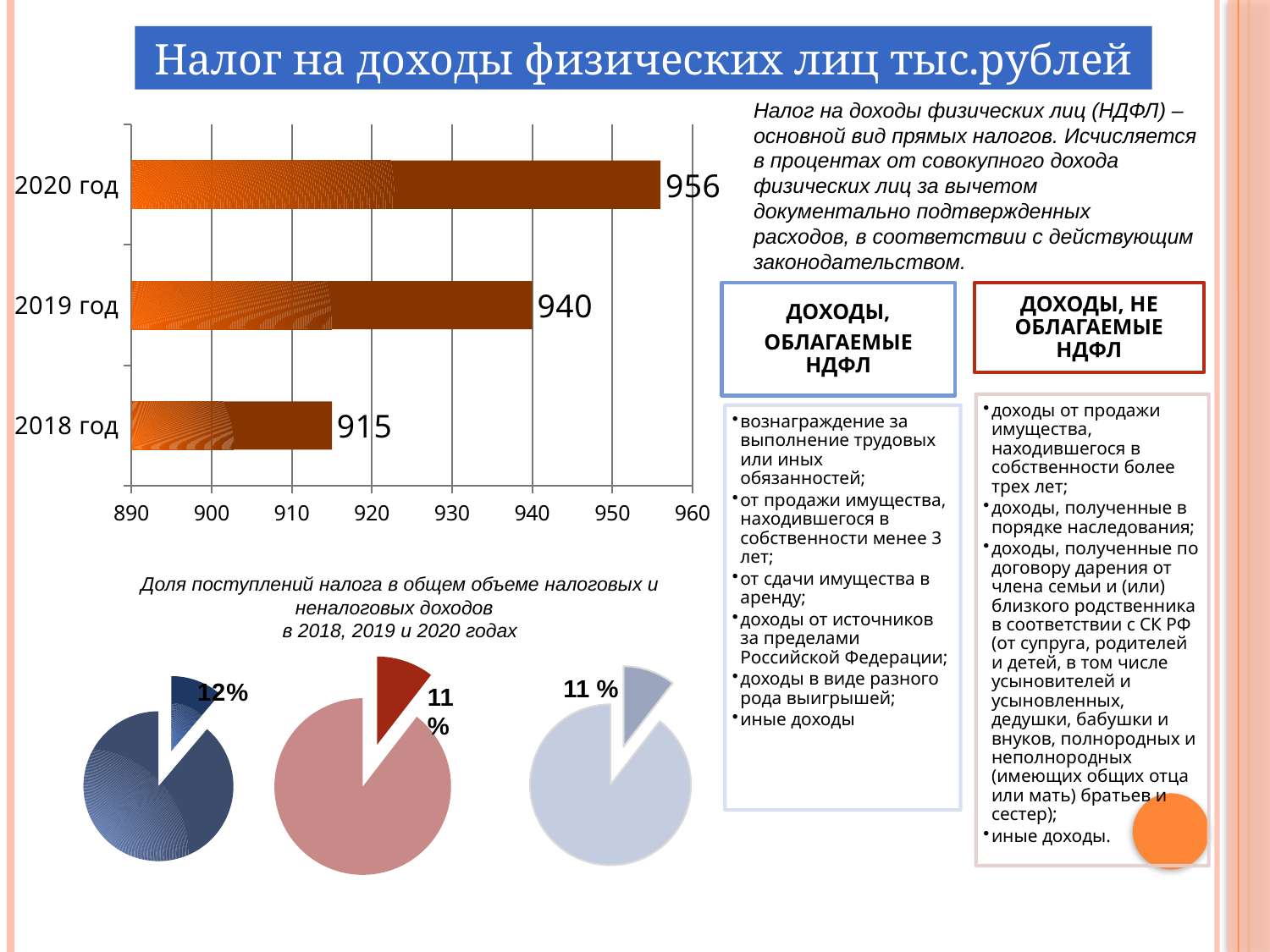
In the bar chart, what is the difference between the values for 2020 год and 2018 год? 41 In the bar chart, what is the value for 2018 год? 915 In the bar chart, do the values rise or fall from 2018 to 2020? rise In the bar chart, which year has the highest value? 2020 год In the bar chart, what is the value for 2020 год? 956 In the leftmost pie chart under 'Доля поступлений налога', what share does the highlighted slice show? 12% What kind of chart is the chart at the top left of the slide? bar chart In the bar chart, what is the value for 2019 год? 940 In the bar chart, what is the difference between the values for 2019 год and 2018 год? 25 In the bar chart, which year has the lowest value? 2018 год In the bar chart, which is larger: the value for 2019 год or 2018 год? 2019 год How many years are shown in the bar chart? 3